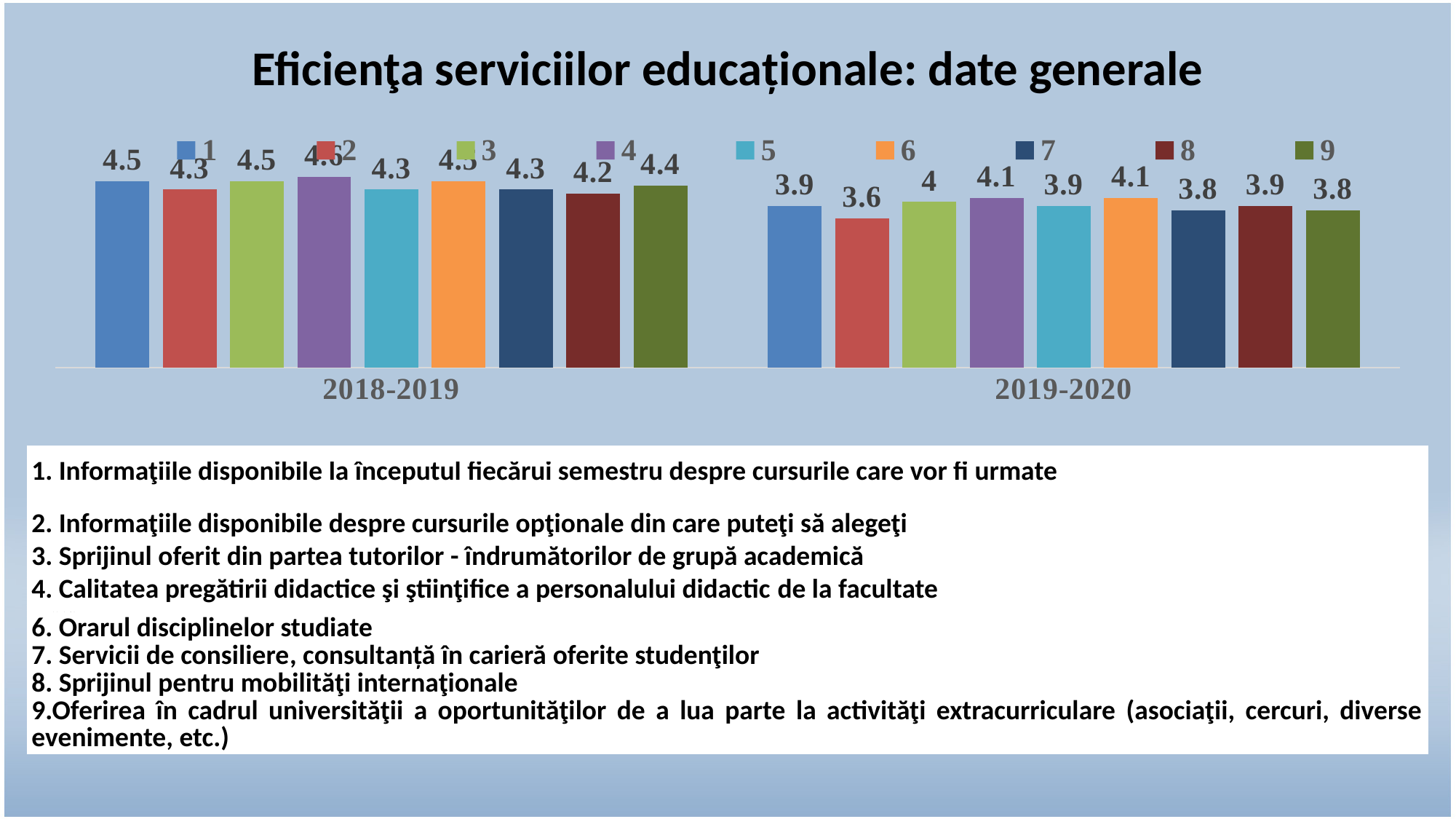
What is the value for series 9 in 2018-2019? 4.4 What is the value for series 7 in 2019-2020? 3.8 For series 8, which year has the larger value, 2018-2019 or 2019-2020? 2018-2019 What is the value for series 2 in 2019-2020? 3.6 What kind of chart is shown on the slide? bar chart Which series has the lowest value in 2019-2020? 2 How many series does the legend list? 9 What is the difference between the value for series 1 in 2018-2019 and in 2019-2020? 0.6 What is the value for series 1 in 2018-2019? 4.5 What is the title of the slide? Eficienţa serviciilor educaționale: date generale How many categories are shown on the x axis? 2 Does the value for series 3 rise or fall from 2018-2019 to 2019-2020? fall